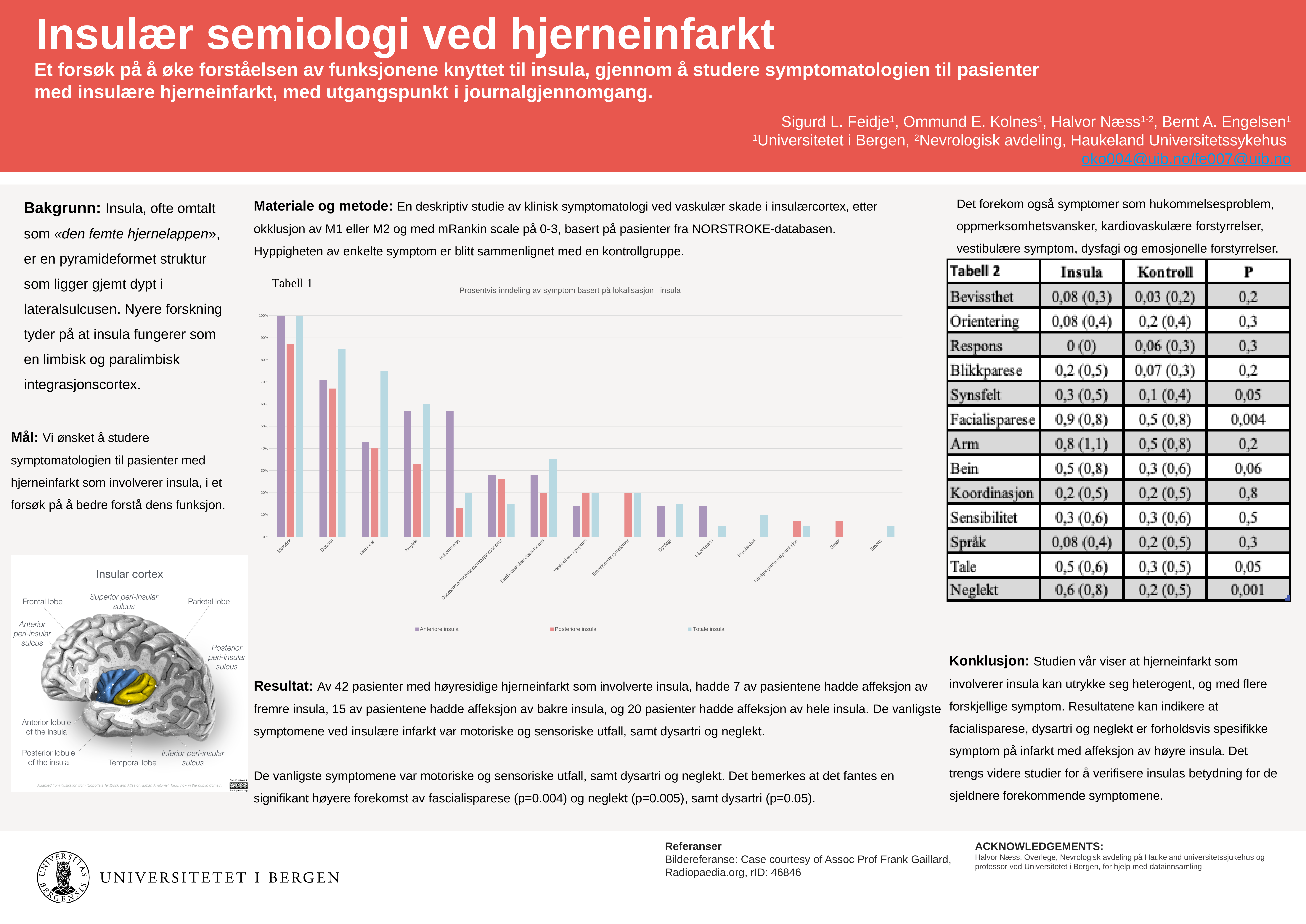
How many series does the legend of the 'Prosentvis inndeling av symptom basert på lokalisasjon i insula' chart list? 3 What are the three legend entries of the bar chart? Anteriore insula, Posteriore insula, Totale insula In the bar chart, what is the Anteriore insula value for Motorisk? 100% What kind of chart is shown under 'Tabell 1' on the slide? bar chart What is the title of the bar chart on the slide? Prosentvis inndeling av symptom basert på lokalisasjon i insula In the bar chart, which symptom category has the highest Totale insula value? Motorisk In the bar chart, is the Posteriore insula value for Neglekt greater or less than 40%? less In the bar chart, which is larger: the Totale insula value for Dysartri or the Totale insula value for Sensorisk? Dysartri In the bar chart, is the Anteriore insula value for Dysartri greater or less than 60%? greater In the bar chart, is the Posteriore insula value for Hukommelse greater or less than 20%? less In the bar chart, which is larger for Neglekt: the Anteriore insula value or the Posteriore insula value? Anteriore insula